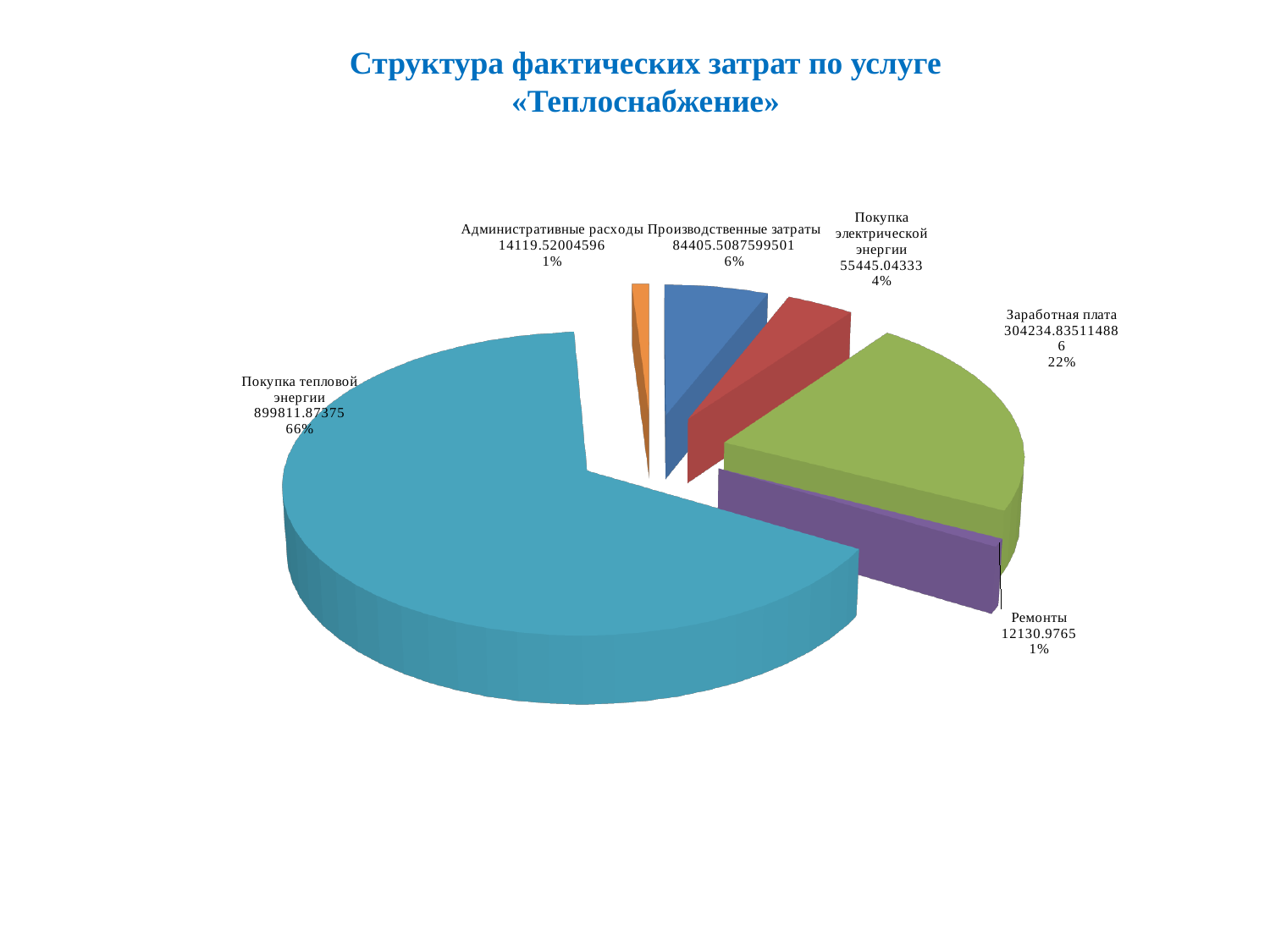
What is the value shown for Ремонты? 12130.9765 How many slices does the pie chart have? 6 What is the value shown for Покупка электрической энергии? 55445.04333 What kind of chart is shown on the slide? Pie chart What is the difference between the values for Административные расходы and Ремонты? 1988.54354596 Which is larger, Производственные затраты or Покупка электрической энергии? Производственные затраты What is the title of the chart? Структура фактических затрат по услуге «Теплоснабжение» Which category has the smallest value in the pie chart? Ремонты Which category has the largest share of the pie? Покупка тепловой энергии What is the value shown for Покупка тепловой энергии? 899811.87375 What share of the pie does Покупка тепловой энергии represent? 66% What share of the pie does Заработная плата represent? 22%